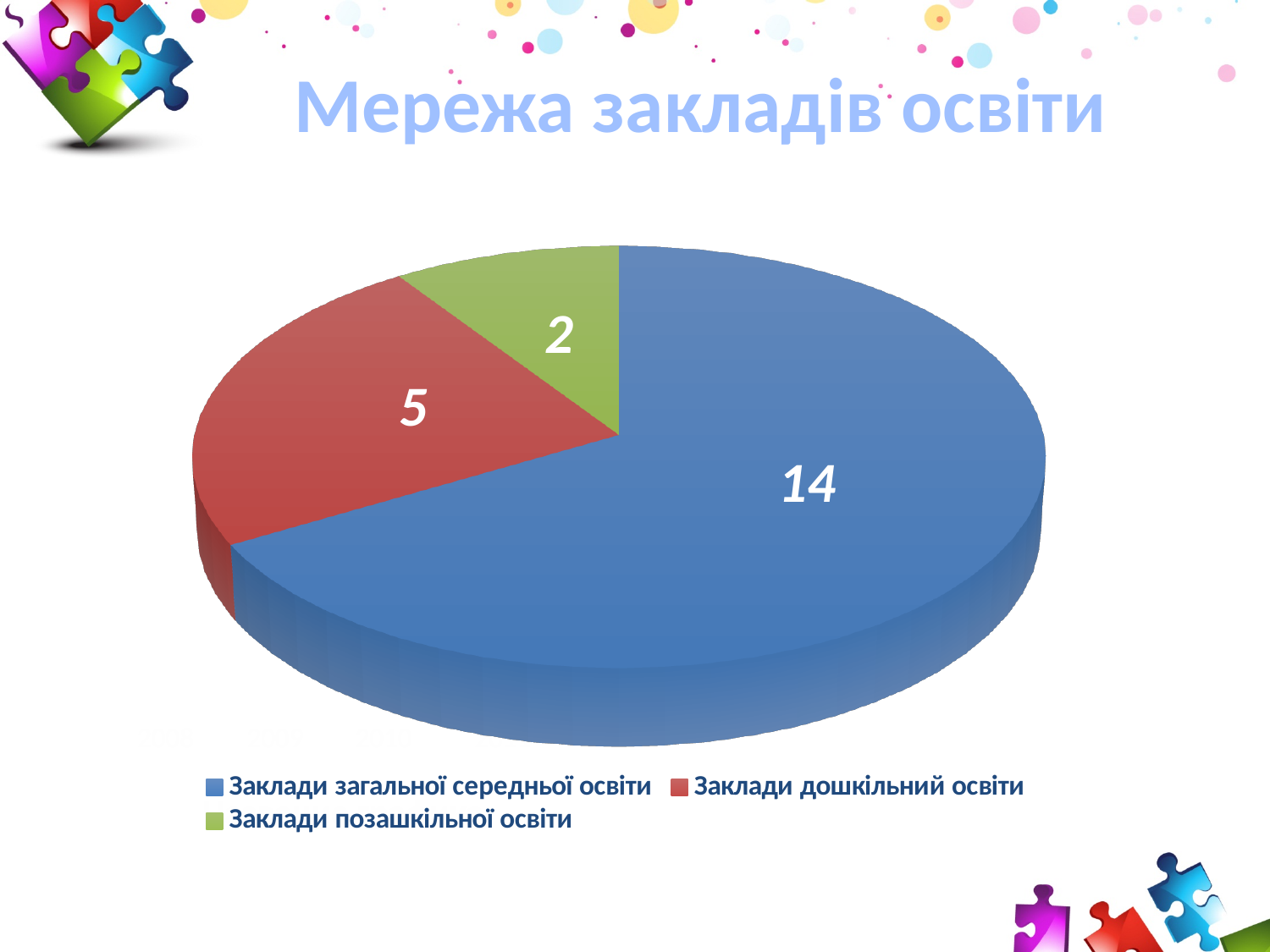
What is the value for Заклади позашкільної освіти? 2 Which category has the smallest slice of the pie? Заклади позашкільної освіти What is the difference between the values for Заклади загальної середньої освіти and Заклади дошкільний освіти? 9 What kind of chart is shown on the slide? Pie chart What is the value for Заклади дошкільний освіти? 5 How many slices does the pie chart have? 3 Which is larger: the value for Заклади дошкільний освіти or Заклади позашкільної освіти? Заклади дошкільний освіти How many entries does the legend list? 3 What is the title of the chart on the slide? Мережа закладів освіти Which category has the largest slice of the pie? Заклади загальної середньої освіти What is the total of all slices in the pie chart? 21 What is the value for Заклади загальної середньої освіти? 14